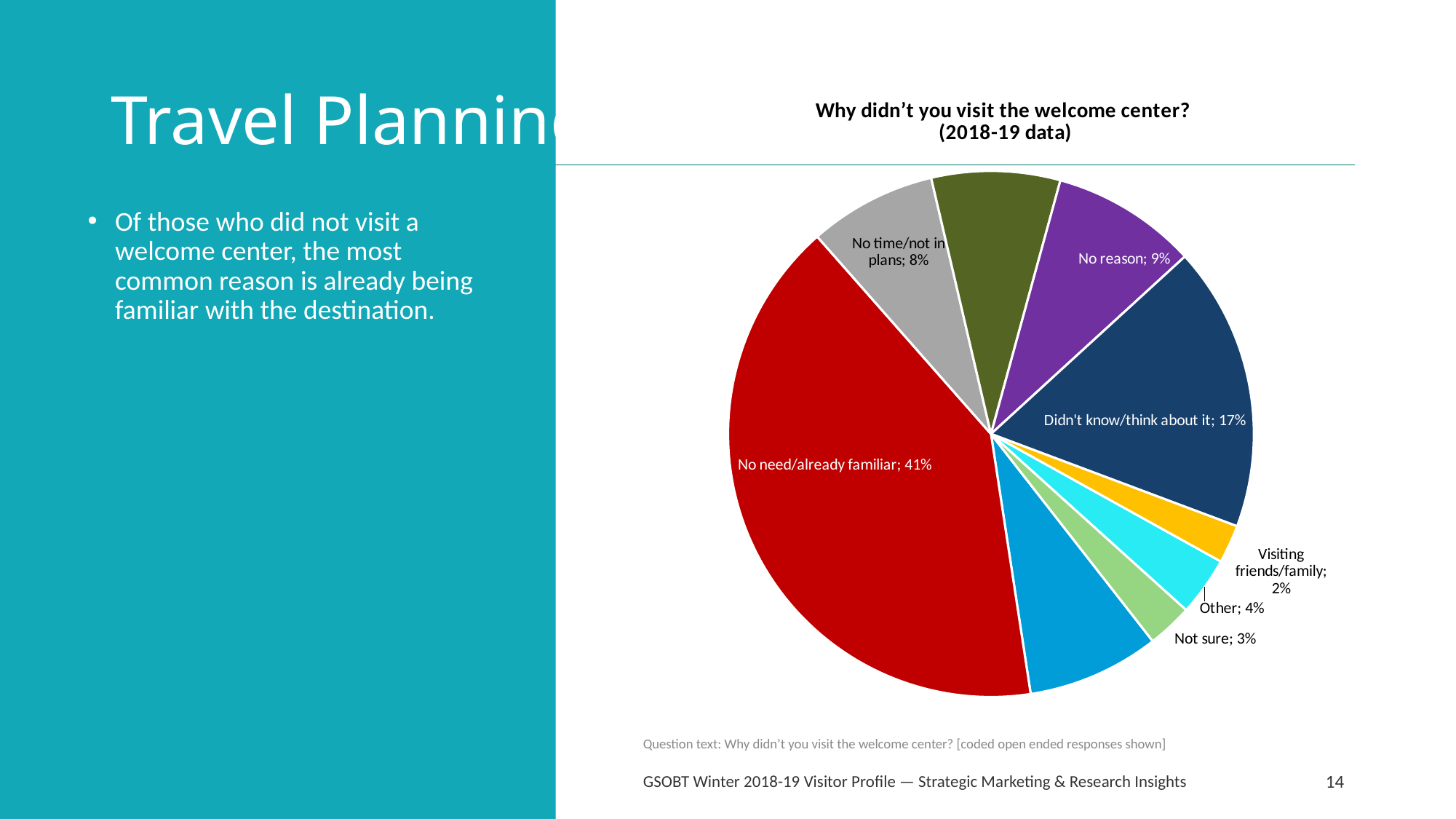
What kind of chart is shown on the slide? Pie chart What percentage is shown for "No time/not in plans"? 8% Which reason has the largest slice of the pie? No need/already familiar What percentage is shown for "Didn't know/think about it"? 17% Which labeled reason has the smallest share? Visiting friends/family What is the title of the chart? Why didn't you visit the welcome center? (2018-19 data) What colour is the "No need/already familiar" slice? Red What share of respondents said "No need/already familiar"? 41% What percentage is shown for "Not sure"? 3% Which is larger, the share for "Other" or the share for "Not sure"? Other What percentage is shown for "No reason"? 9% How many percentage points larger is "No need/already familiar" than "Didn't know/think about it"? 24